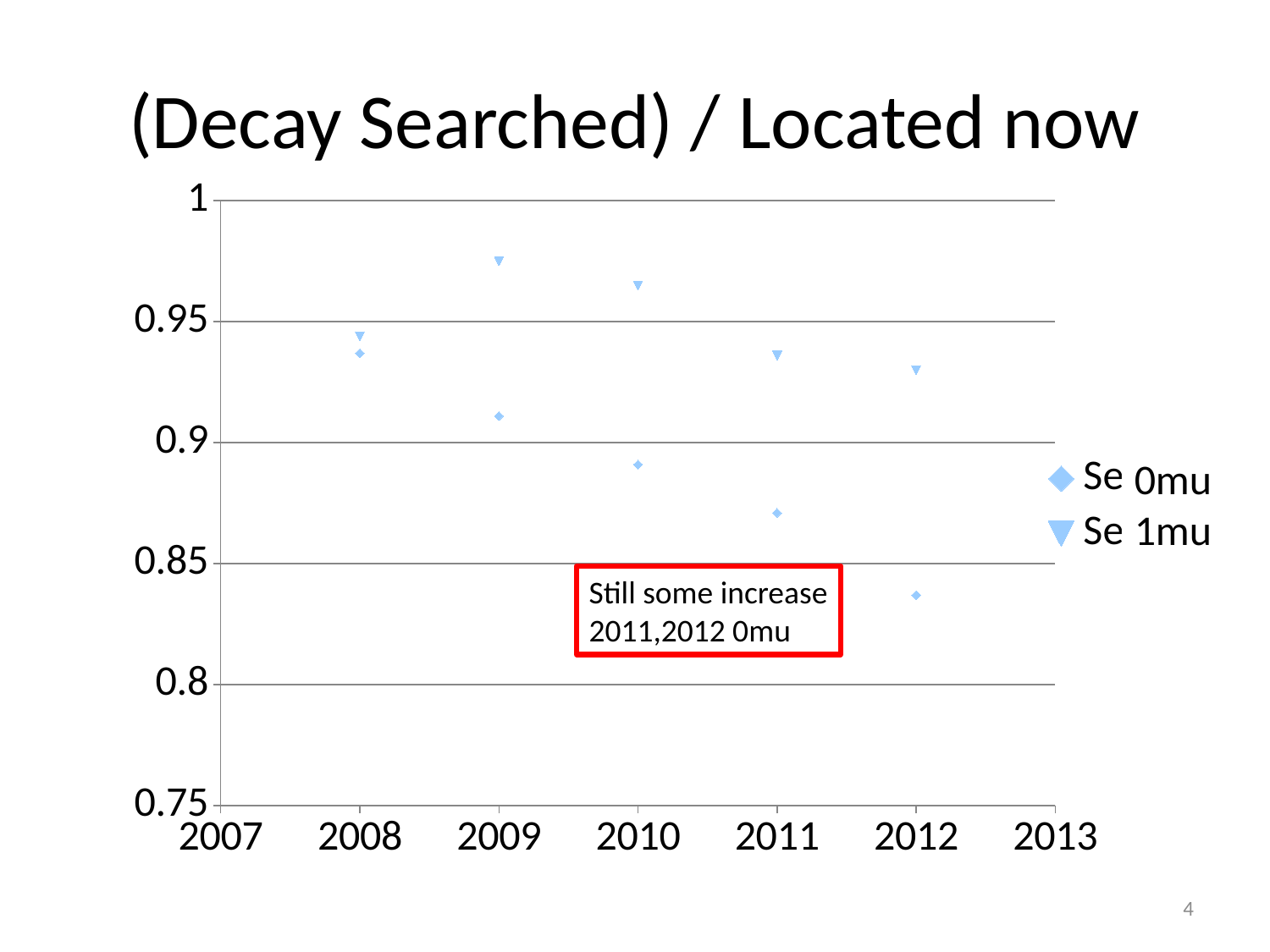
What is the title of the chart? (Decay Searched) / Located now Which series has the larger value in 2010, Se 0mu or Se 1mu? Se 1mu Is the Se 1mu value for 2009 greater or less than 0.95? greater What does the red-boxed annotation on the chart say? Still some increase 2011,2012 0mu In which year is the Se 1mu value highest? 2009 What kind of chart is shown on the slide? scatter chart Is the Se 0mu value for 2012 greater or less than 0.85? less In which year is the Se 0mu value highest? 2008 In which year is the Se 0mu value lowest? 2012 How many series does the legend list? 2 Do the Se 0mu values rise or fall from 2008 to 2012? fall How many data points are plotted for the Se 0mu series? 5